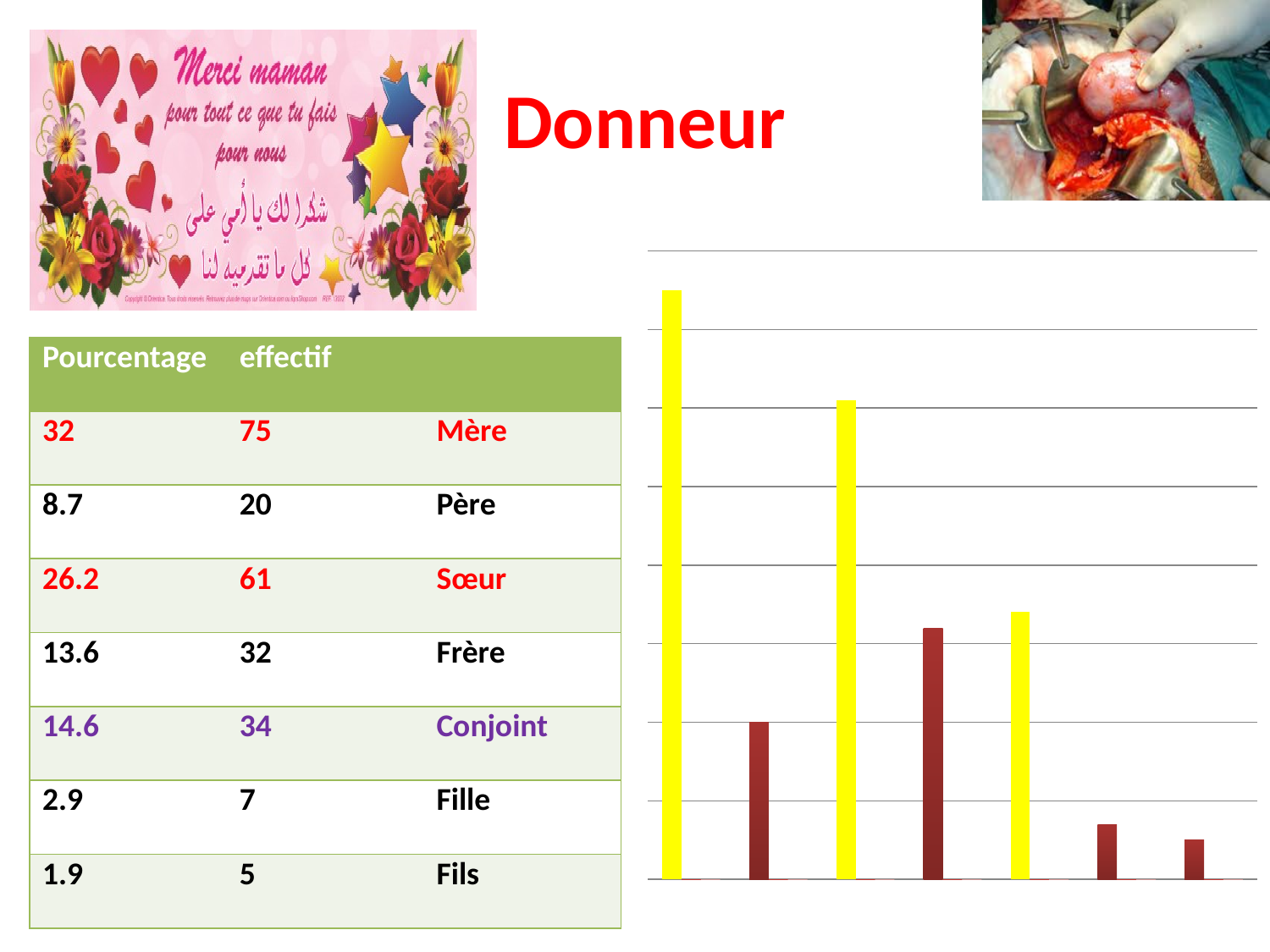
In the chart on the right side of the slide, which is taller: the third bar or the fifth bar? the third bar In the chart on the right side of the slide, which bar is the tallest, counting from the left? the first bar In the chart on the right side of the slide, which bar is the shortest, counting from the left? the seventh bar What kind of chart is shown on the right side of the slide? bar chart What two colours are used for the bars in the chart on the right side of the slide? yellow and dark red In the chart on the right side of the slide, which is taller: the second bar or the fourth bar? the fourth bar How many bars are plotted in the chart on the right side of the slide? 7 In the chart on the right side of the slide, which is taller: the sixth bar or the seventh bar? the sixth bar Do the last three bars of the chart on the right side of the slide rise or fall from left to right? fall In the chart on the right side of the slide, what colour is the tallest bar? yellow